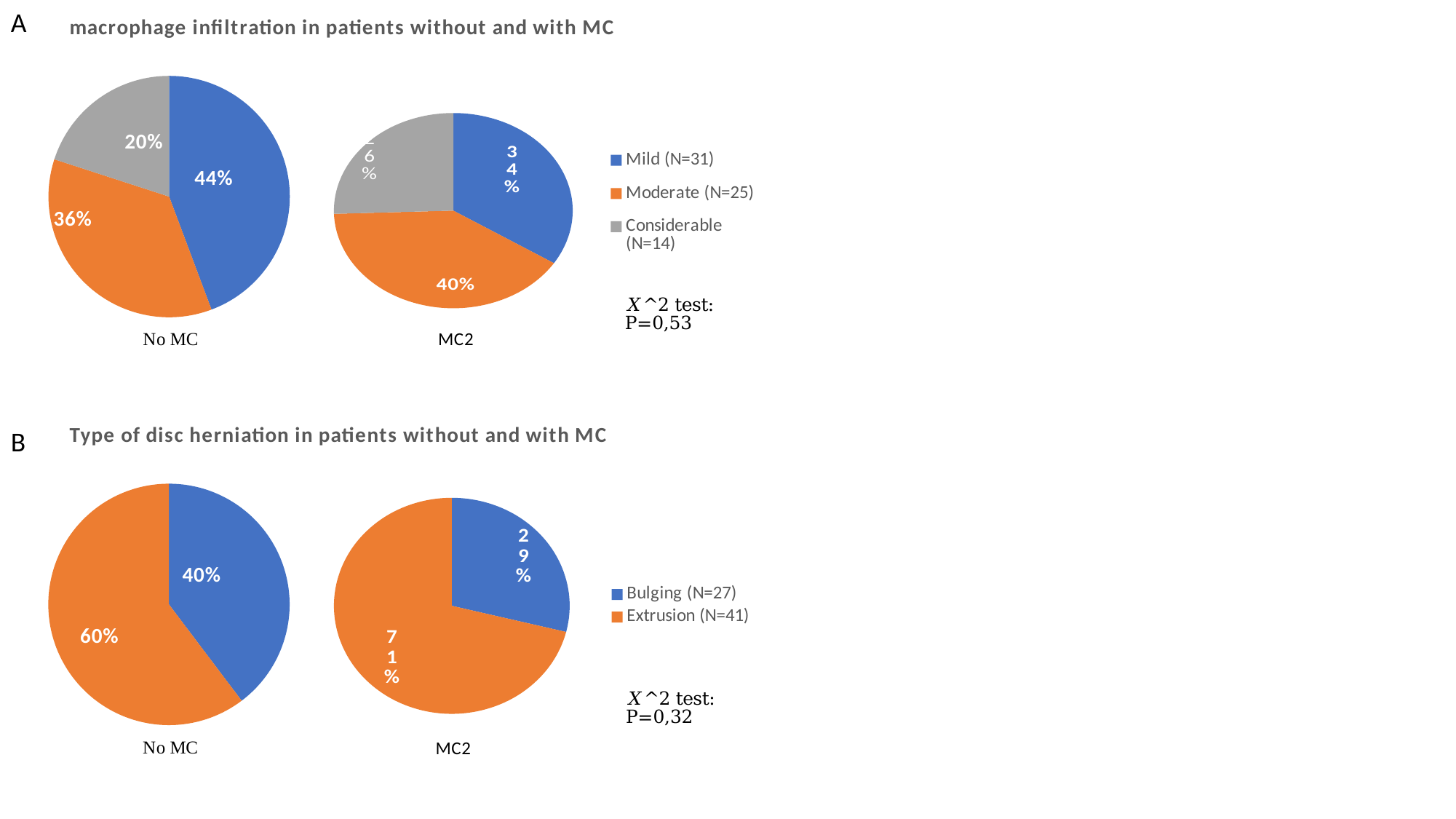
In the 'Type of disc herniation in patients without and with MC' chart, what is the difference between the Extrusion and Bulging shares in the MC2 pie? 42% In the 'macrophage infiltration in patients without and with MC' chart, what share of the MC2 pie is Moderate? 40% What kind of chart is used in the 'Type of disc herniation in patients without and with MC' panel? Pie chart In the 'Type of disc herniation in patients without and with MC' chart, what share of the No MC pie is Extrusion? 60% In the 'macrophage infiltration in patients without and with MC' chart, how many categories does the legend list? 3 In the 'Type of disc herniation in patients without and with MC' chart, what share of the MC2 pie is Bulging? 29% In the 'macrophage infiltration in patients without and with MC' chart, which category has the largest slice in the No MC pie? Mild In the 'macrophage infiltration in patients without and with MC' chart, which category has the smallest slice in the No MC pie? Considerable